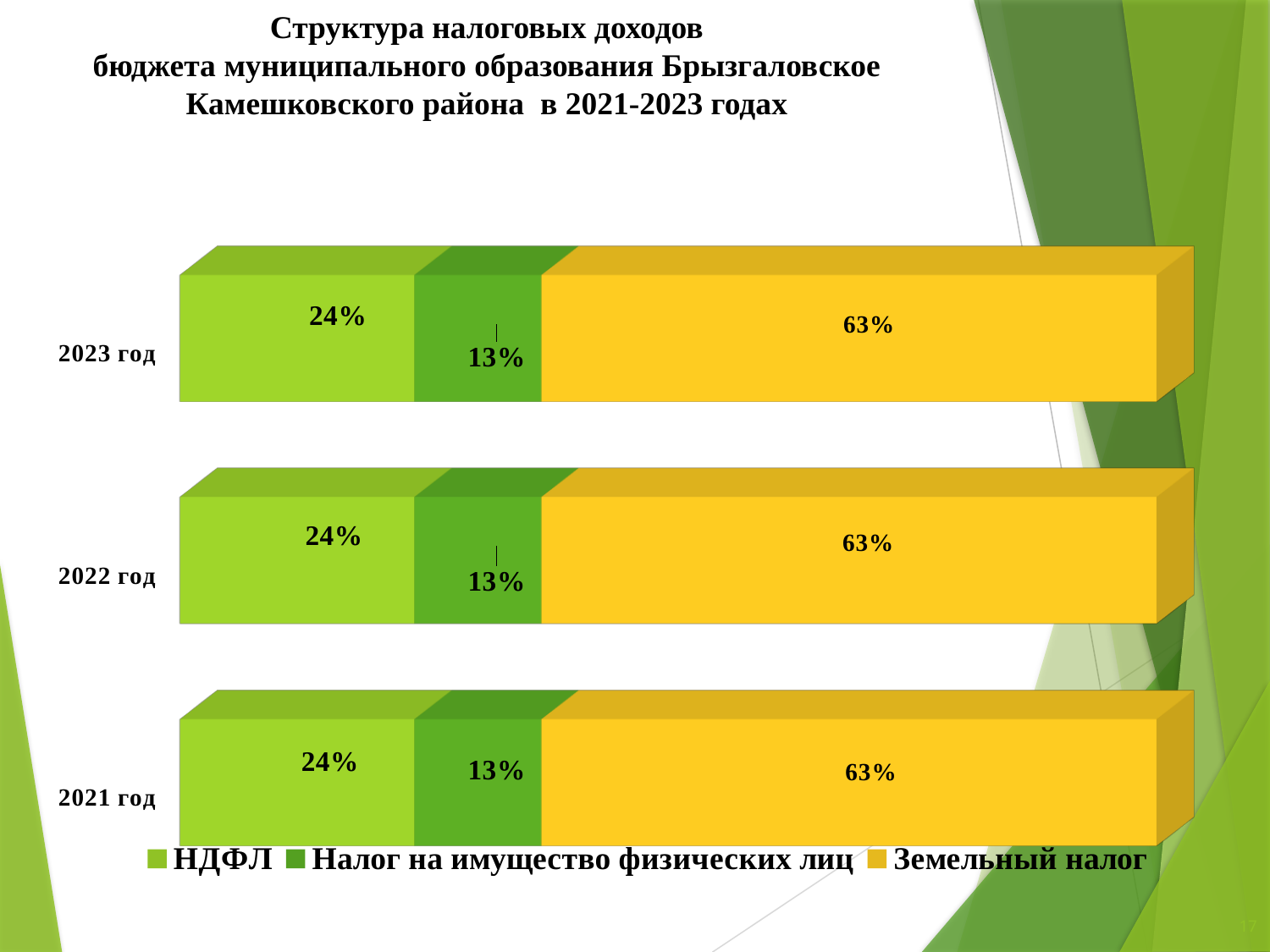
What is the value for Налог на имущество физических лиц in 2022 год? 13% Does the share of Земельный налог change from 2021 год to 2023 год? No, it stays at 63% How many years (categories) are shown on the chart? 3 In 2023 год, which is larger: the share of НДФЛ or the share of Налог на имущество физических лиц? НДФЛ What share of tax revenues does Земельный налог account for in 2023 год? 63% Which series has the smallest share in 2023 год? Налог на имущество физических лиц What is the difference between the Земельный налог share and the НДФЛ share in 2021 год? 39% What is the value for НДФЛ in 2021 год? 24% What kind of chart is shown on the slide? Stacked bar chart Which series has the largest share in 2022 год? Земельный налог How many series does the legend list? 3 Which colour represents Земельный налог in the legend? Yellow